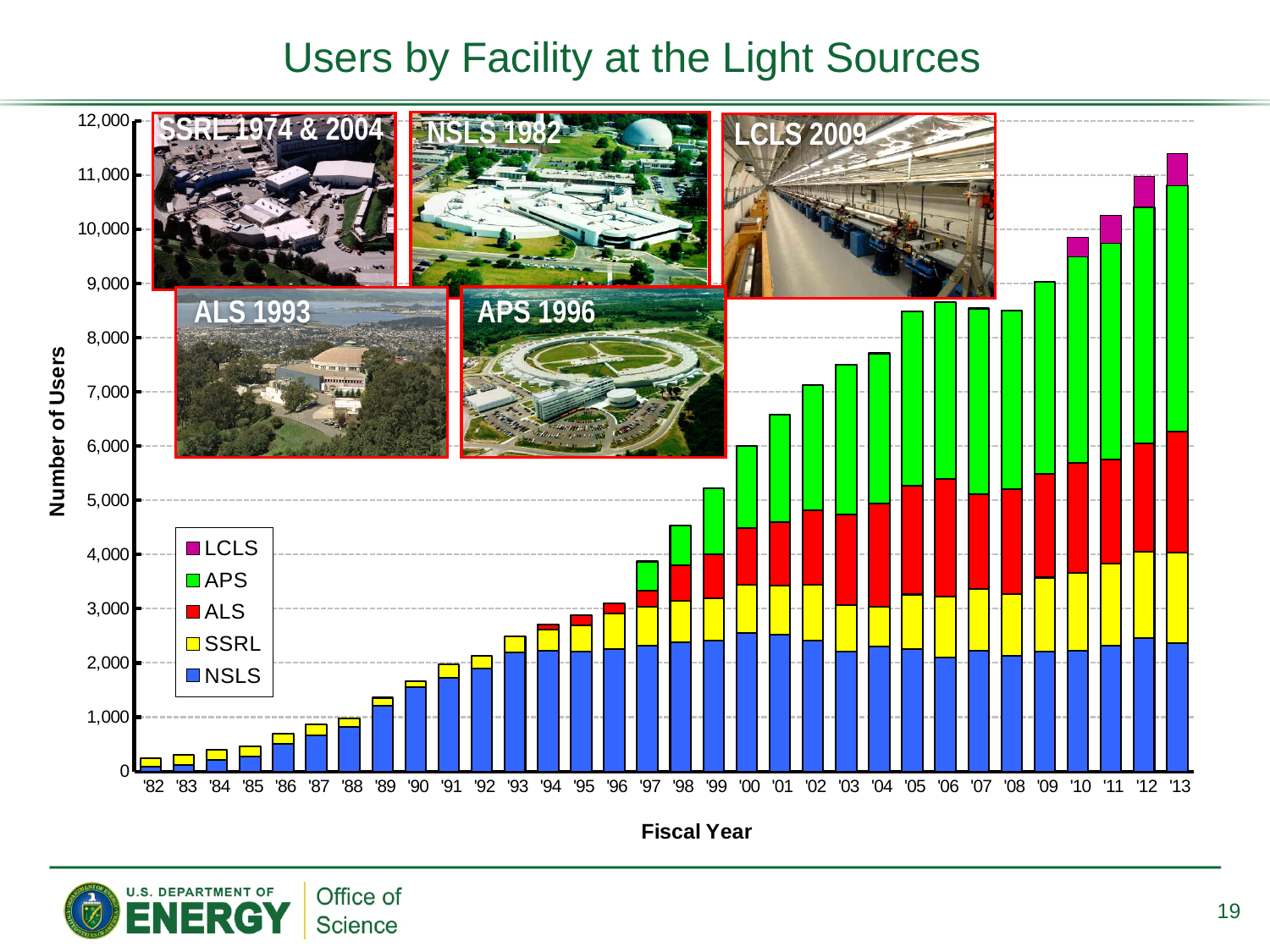
What is the title of the chart? Users by Facility at the Light Sources How many fiscal years are shown along the x axis? 32 Is the total number of users for '90 greater or less than 2,000? less Does the total number of users generally rise or fall from '82 to '13? rise Is the total number of users for '05 greater or less than 8,000? greater Is the total number of users for '13 greater or less than 11,000? greater Which fiscal year has a larger total number of users, '98 or '99? '99 Which fiscal year has the highest total number of users? '13 How many series does the legend list? 5 What is the label on the y axis? Number of Users What kind of chart is shown on the slide? stacked bar chart Which fiscal year has the lowest total number of users? '82